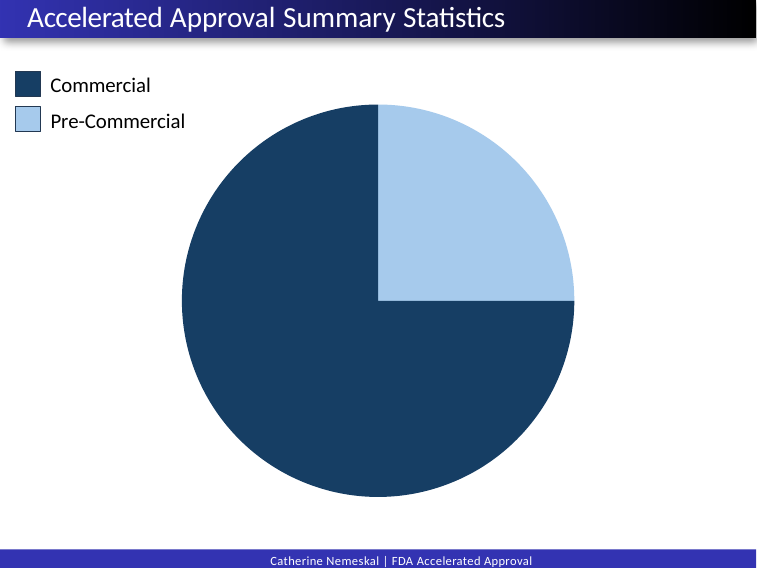
How many slices does the pie chart have? 2 Does the Commercial slice take up more or less than half of the pie chart? more Which category has the largest slice of the pie chart? Commercial What kind of chart is shown on the slide? pie chart How many entries does the legend of the pie chart list? 2 Which slice is larger, Commercial or Pre-Commercial? Commercial Which category is shown in the lighter blue colour in the pie chart? Pre-Commercial Which category has the smallest slice of the pie chart? Pre-Commercial What is the title of the slide containing the pie chart? Accelerated Approval Summary Statistics